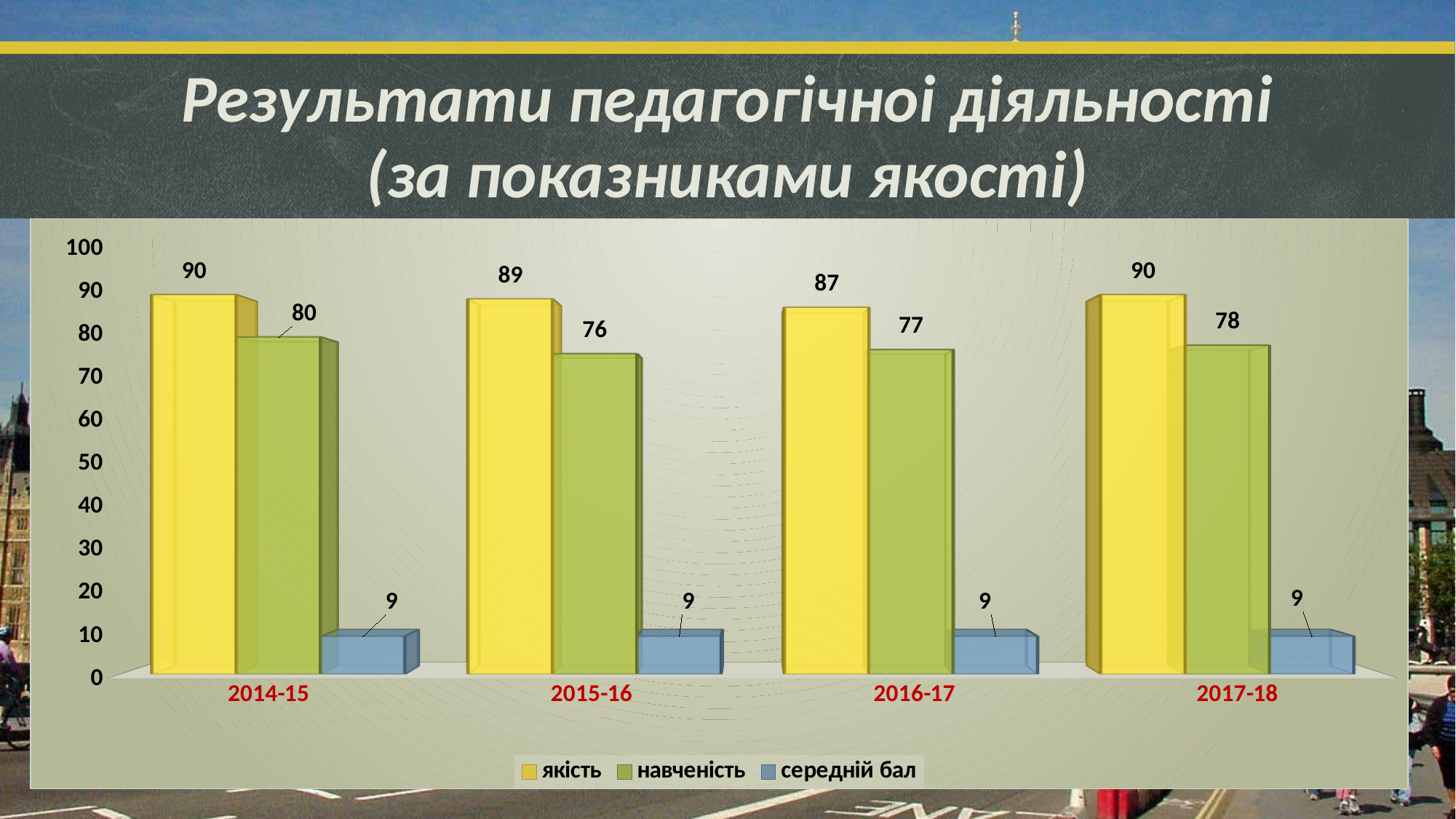
What is the difference between якість and навченість in 2015-16? 13 What is the value of навченість for 2015-16? 76 In which year is навченість lowest? 2015-16 What is the value of середній бал for 2016-17? 9 What kind of chart is shown on the slide? bar chart What is the value of якість for 2014-15? 90 Which is larger, якість in 2016-17 or якість in 2017-18? якість in 2017-18 Which series is shown in blue in the legend? середній бал How many year categories are shown on the x axis? 4 What is the value of навченість for 2017-18? 78 How many series does the legend list? 3 In which year is якість lowest? 2016-17